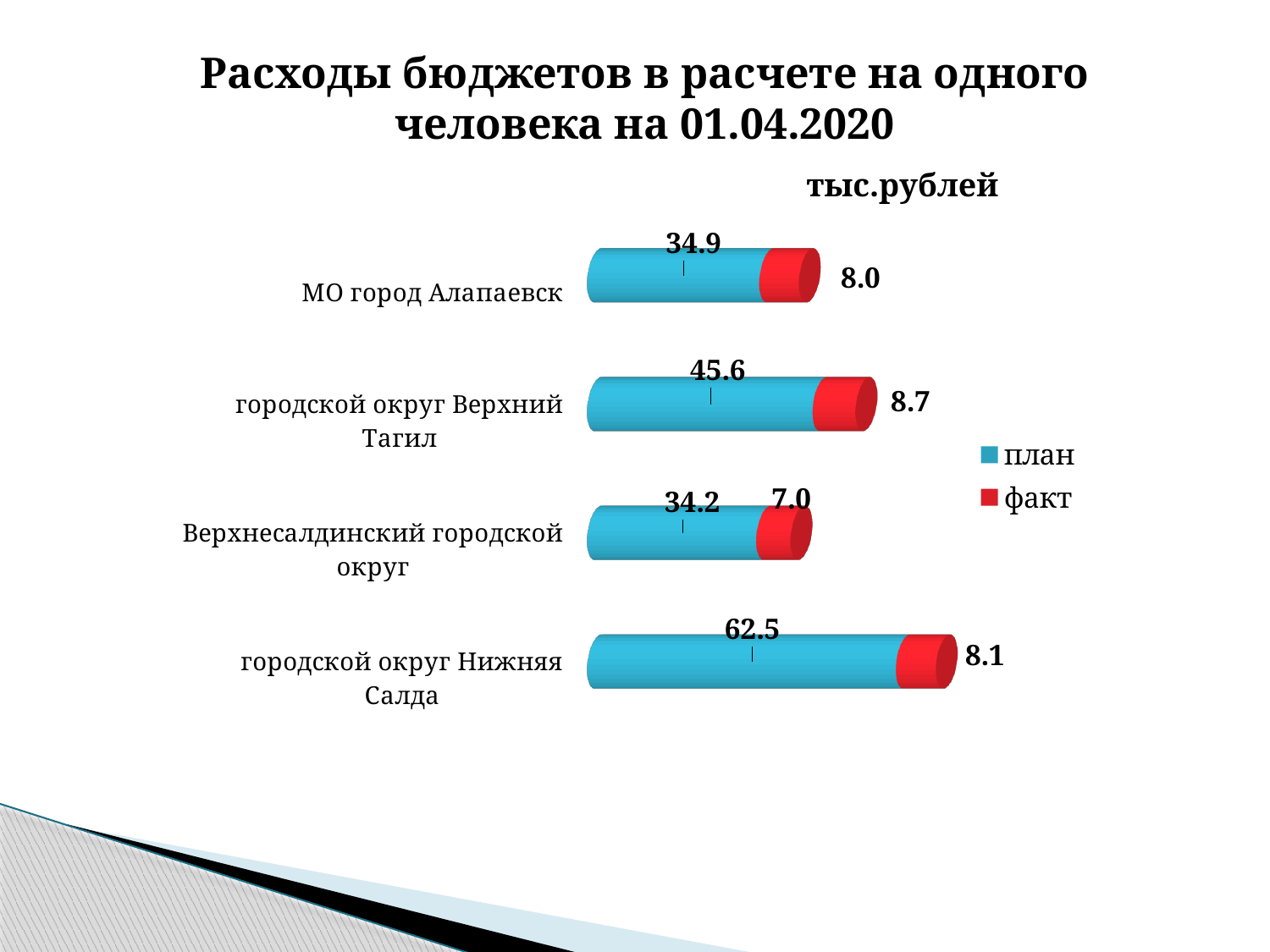
Which is larger, the факт value for МО город Алапаевск or for городской округ Нижняя Салда? городской округ Нижняя Салда How many series does the legend list? 2 What kind of chart is shown on the slide? bar chart Which category has the highest план value? городской округ Нижняя Салда What is the факт value for городской округ Верхний Тагил? 8.7 What is the difference between the план values for городской округ Нижняя Салда and городской округ Верхний Тагил? 16.9 How many categories are shown in the chart? 4 Which category has the lowest факт value? Верхнесалдинский городской округ What is the факт value for Верхнесалдинский городской округ? 7.0 What unit is indicated above the chart? тыс.рублей What is the план value for городской округ Нижняя Салда? 62.5 What is the план value for МО город Алапаевск? 34.9